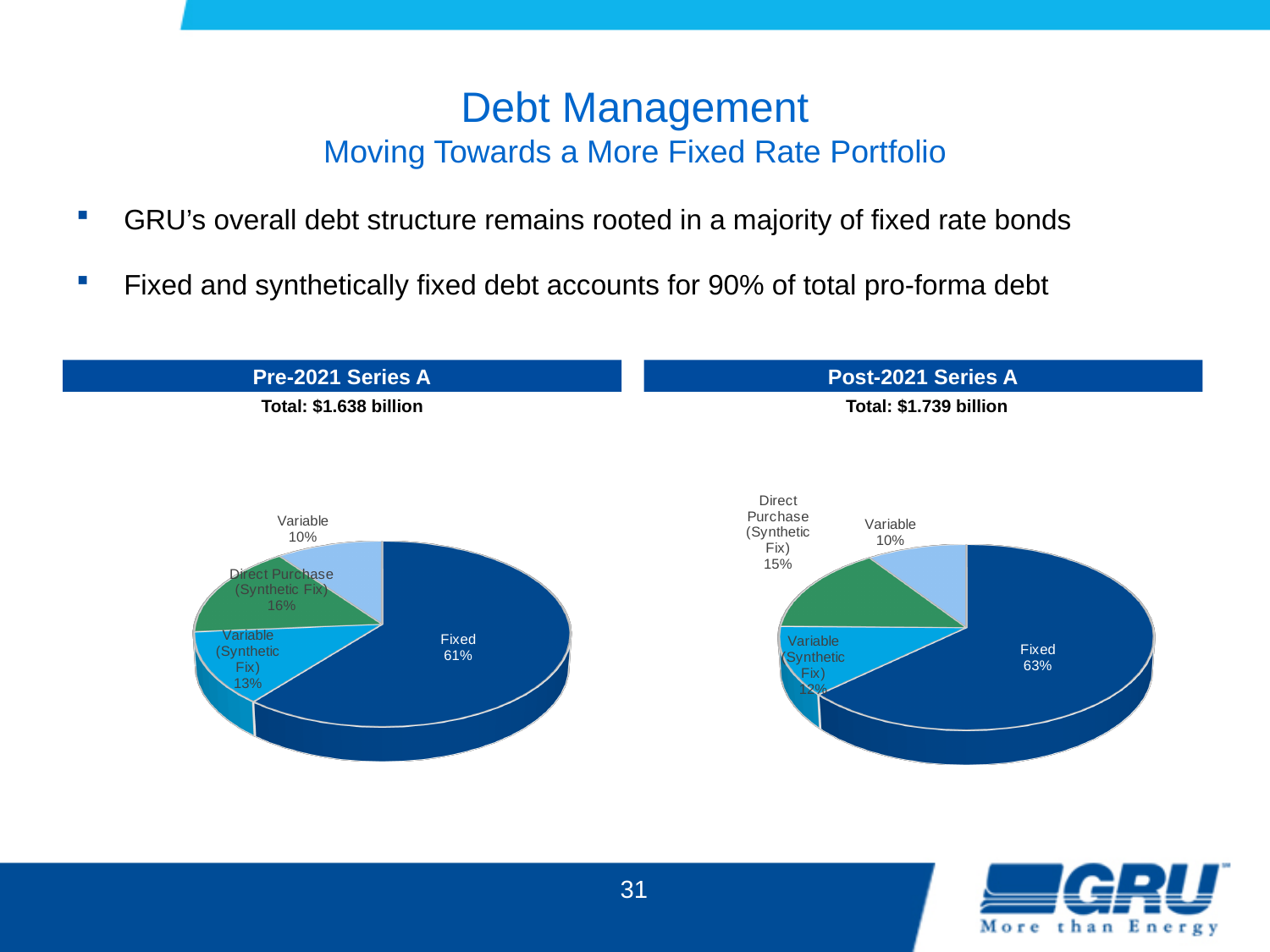
What type of chart is used for the Pre-2021 Series A and Post-2021 Series A portfolios? Pie chart What is the difference in percentage points between the Fixed share in the Post-2021 Series A chart and the Fixed share in the Pre-2021 Series A chart? 2 percentage points How many slices does the Pre-2021 Series A pie chart have? 4 In the Pre-2021 Series A pie chart, what share is Variable (Synthetic Fix)? 13% Is the Direct Purchase (Synthetic Fix) share larger in the Pre-2021 Series A chart or the Post-2021 Series A chart? Pre-2021 Series A In the Post-2021 Series A pie chart, what share is Direct Purchase (Synthetic Fix)? 15% In the Pre-2021 Series A pie chart, which category has the smallest slice? Variable In the Post-2021 Series A pie chart, what share of the portfolio is Fixed? 63% In the Pre-2021 Series A pie chart, which category has the largest slice? Fixed In the Pre-2021 Series A pie chart, what share is Direct Purchase (Synthetic Fix)? 16% In the Pre-2021 Series A pie chart, what share of the portfolio is Fixed? 61% In the Post-2021 Series A pie chart, which category has the largest slice? Fixed